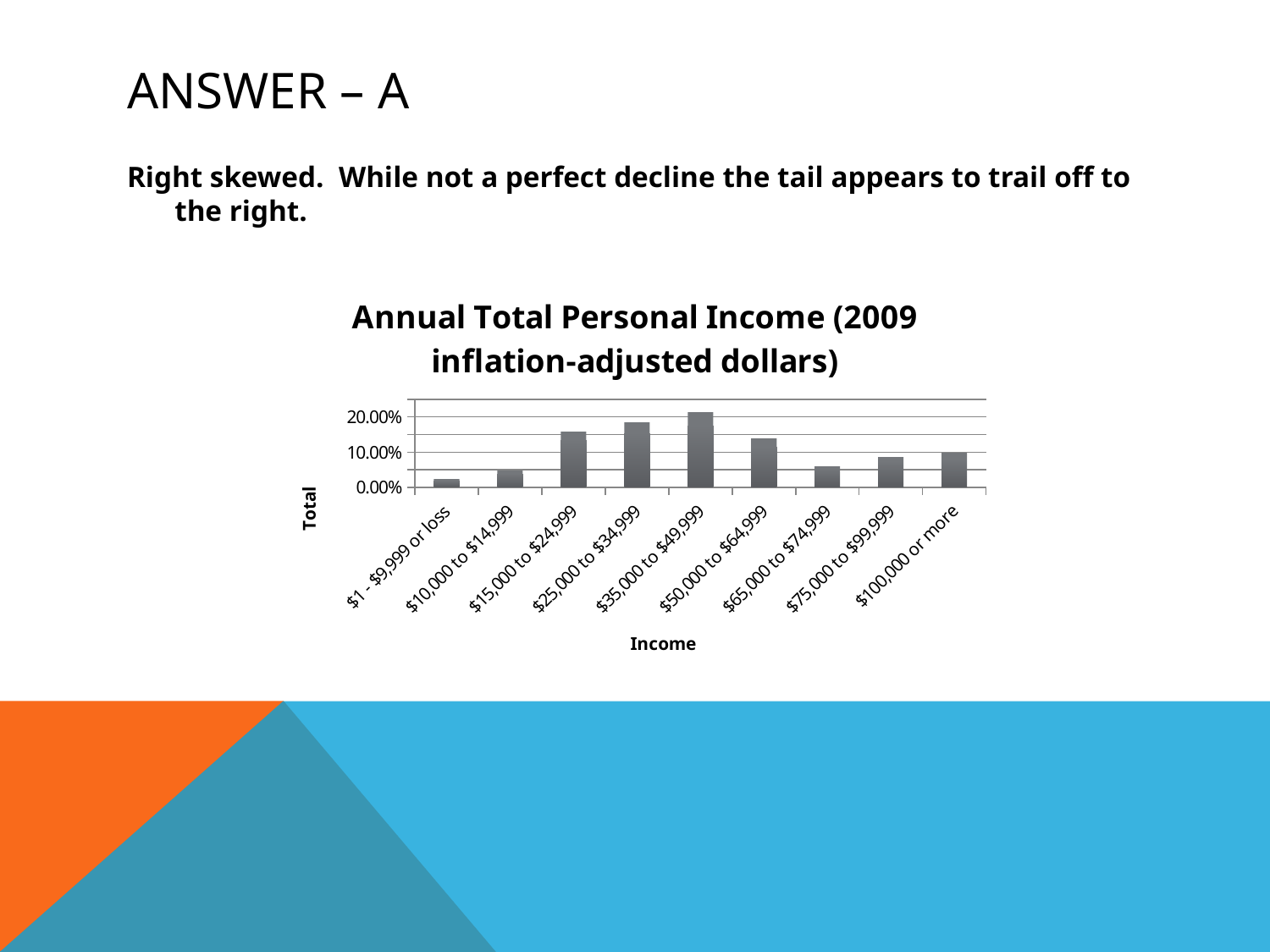
Is the value for $65,000 to $74,999 greater or less than 10.00%? less Is the value for $15,000 to $24,999 greater or less than 10.00%? greater Which is larger, the value for $25,000 to $34,999 or the value for $50,000 to $64,999? $25,000 to $34,999 Do the values rise or fall from $35,000 to $49,999 through $65,000 to $74,999? fall Which income category has the highest value in the chart? $35,000 to $49,999 What kind of chart is shown on the slide? bar chart How many income categories are shown on the x axis of the chart? 9 Which income category has the lowest value in the chart? $1 - $9,999 or loss Is the value for $10,000 to $14,999 greater or less than 10.00%? less Which is larger, the value for $15,000 to $24,999 or the value for $75,000 to $99,999? $15,000 to $24,999 What is the title of the chart? Annual Total Personal Income (2009 inflation-adjusted dollars) What is the label on the x axis of the chart? Income